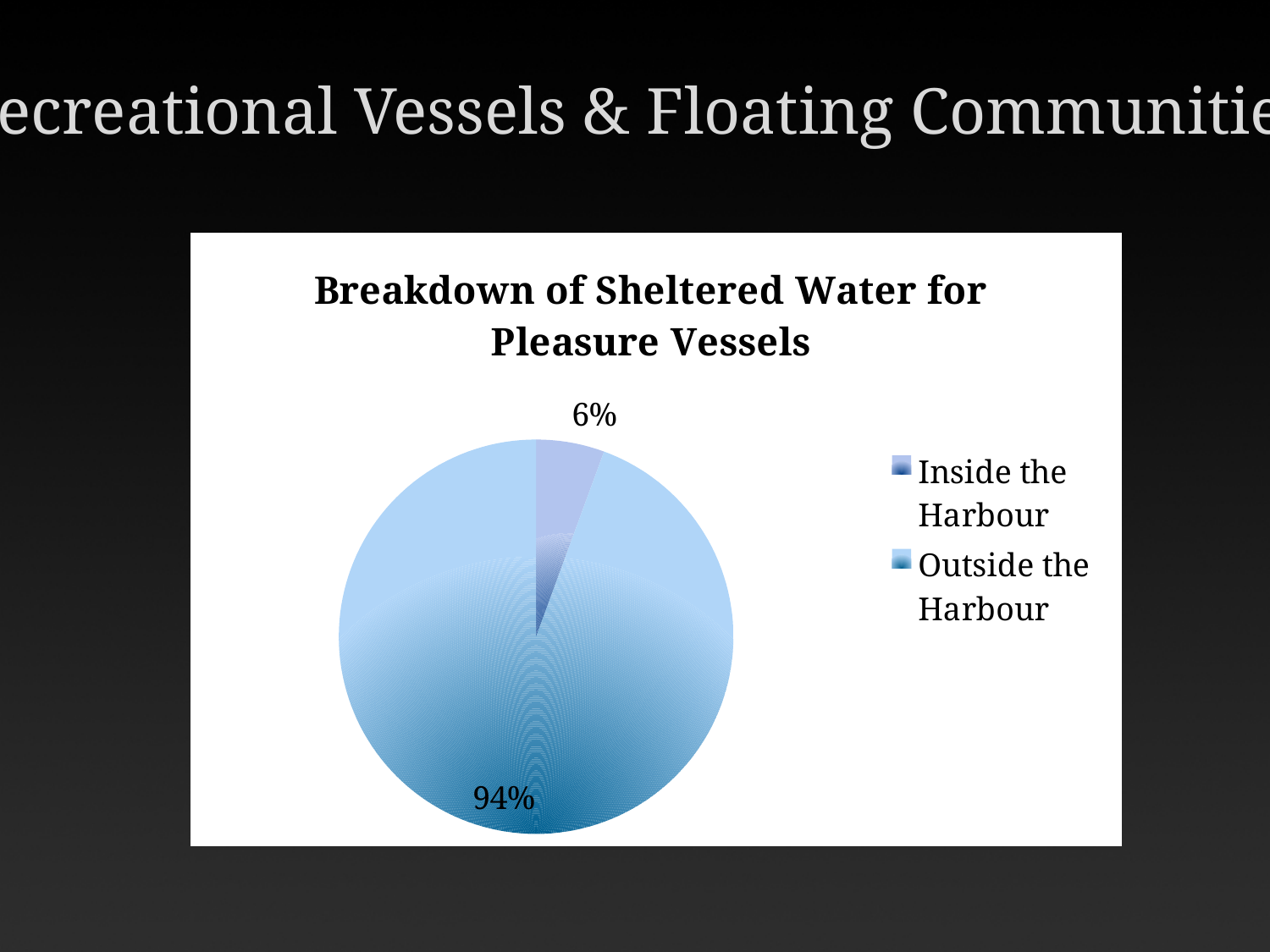
What is the difference in percentage points between the Outside the Harbour and Inside the Harbour slices? 88 What share of the pie is labelled for Inside the Harbour? 6% Which is larger, the Inside the Harbour slice or the Outside the Harbour slice? Outside the Harbour How many slices does the pie chart have? 2 What kind of chart is shown on the slide? pie chart Which category has the largest slice of the pie? Outside the Harbour Is the value for Inside the Harbour greater or less than 10%? less What share of the pie is labelled for Outside the Harbour? 94% Is the value for Outside the Harbour greater or less than 50%? greater How many entries does the legend list? 2 What is the title of the chart? Breakdown of Sheltered Water for Pleasure Vessels Which category has the smallest slice of the pie? Inside the Harbour